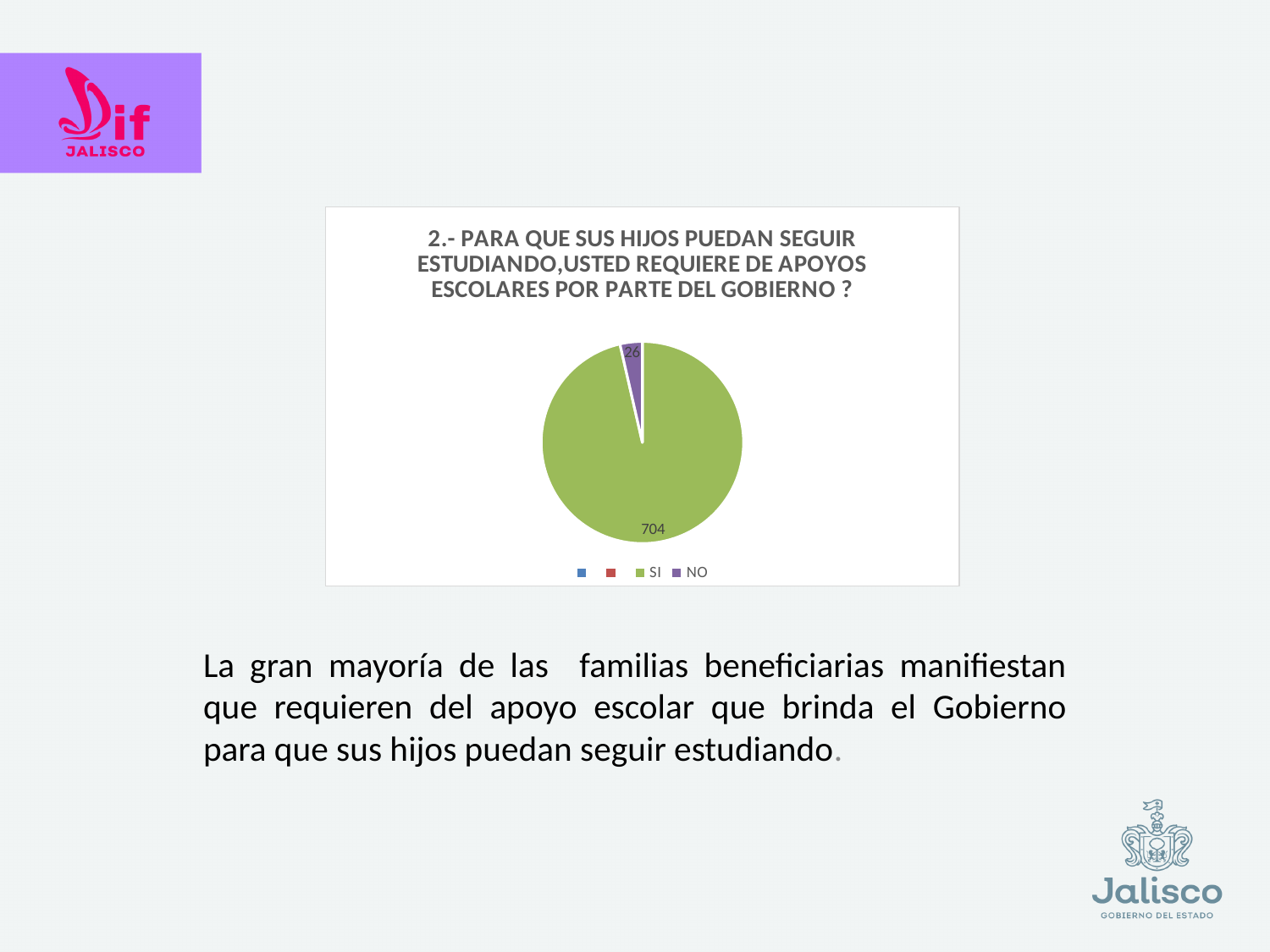
What is the total of the two values shown in the pie chart? 730 What value is shown for the NO slice of the pie chart? 26 How many slices with data labels does the pie chart have? 2 Which is larger in the pie chart, SI or NO? SI Is the value for SI greater or less than 500? greater What value is shown for the SI slice of the pie chart? 704 Which category has the largest slice in the pie chart? SI What kind of chart is shown on the slide? Pie chart What colour is the SI slice in the pie chart? Green What is the difference between the SI and NO values in the pie chart? 678 Which category has the smallest slice in the pie chart? NO What colour is the NO slice in the pie chart? Purple